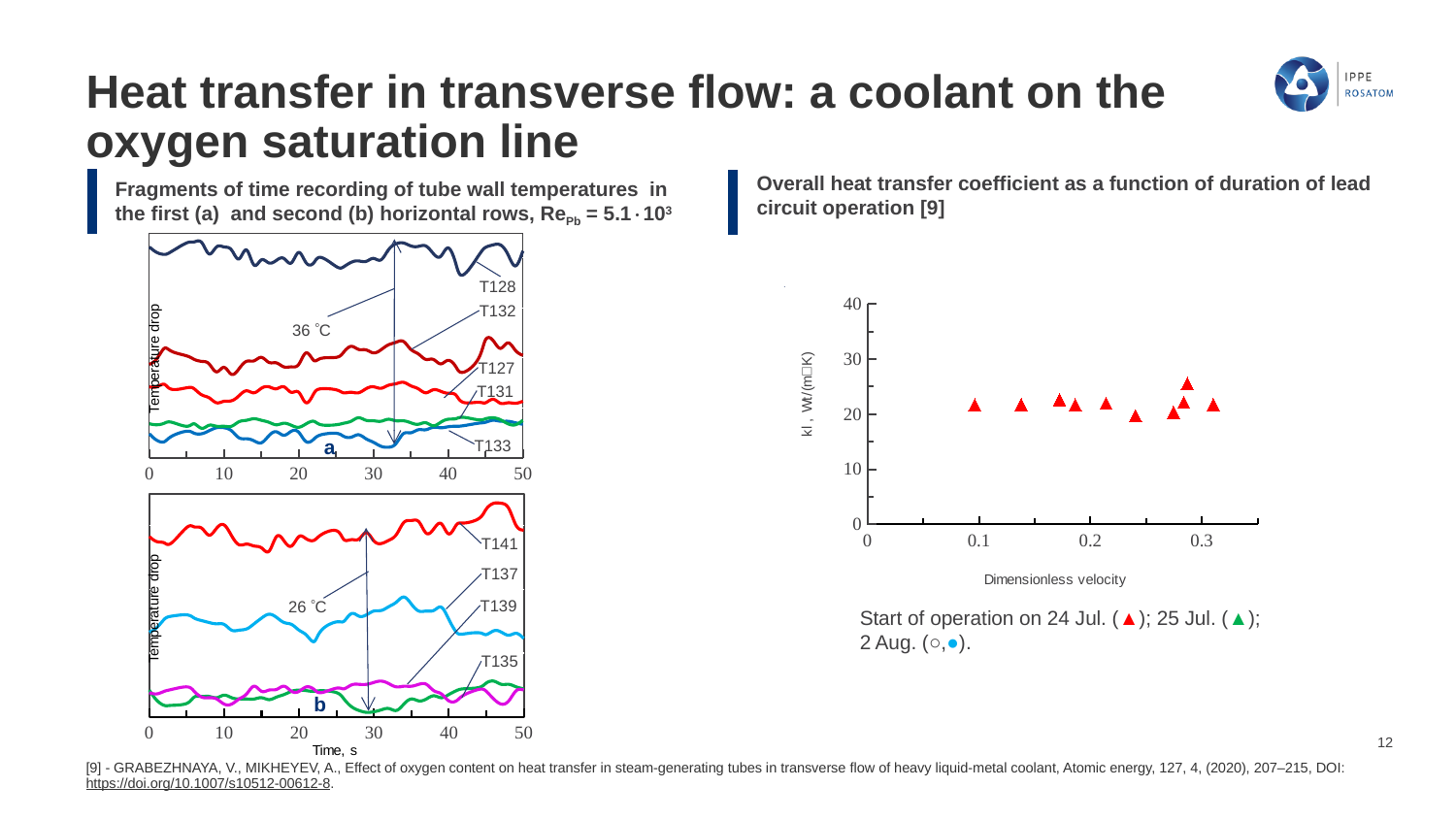
What temperature difference is annotated between the curves in the left-hand chart (b)? 26 °C In the right-hand scatter chart, is the highest plotted value greater or less than 30? less In the left-hand chart (b), which labelled curve lies highest on the temperature drop axis? T141 What kind of charts are the two left-hand charts (a) and (b) showing tube wall temperatures? line charts How many temperature curves are labelled in the left-hand chart (b)? 4 What is the label of the x axis of the right-hand scatter chart? Dimensionless velocity In the right-hand scatter chart, is the lowest plotted value greater or less than 10? greater What temperature difference is annotated between the curves in the left-hand chart (a)? 36 °C In the left-hand chart (a), which labelled curve lies highest on the temperature drop axis? T128 In the right-hand scatter chart, is the value at dimensionless velocity 0.1 greater or less than 30? less What kind of chart is the right-hand chart titled 'Overall heat transfer coefficient as a function of duration of lead circuit operation'? scatter chart How many temperature curves are labelled in the left-hand chart (a)? 5